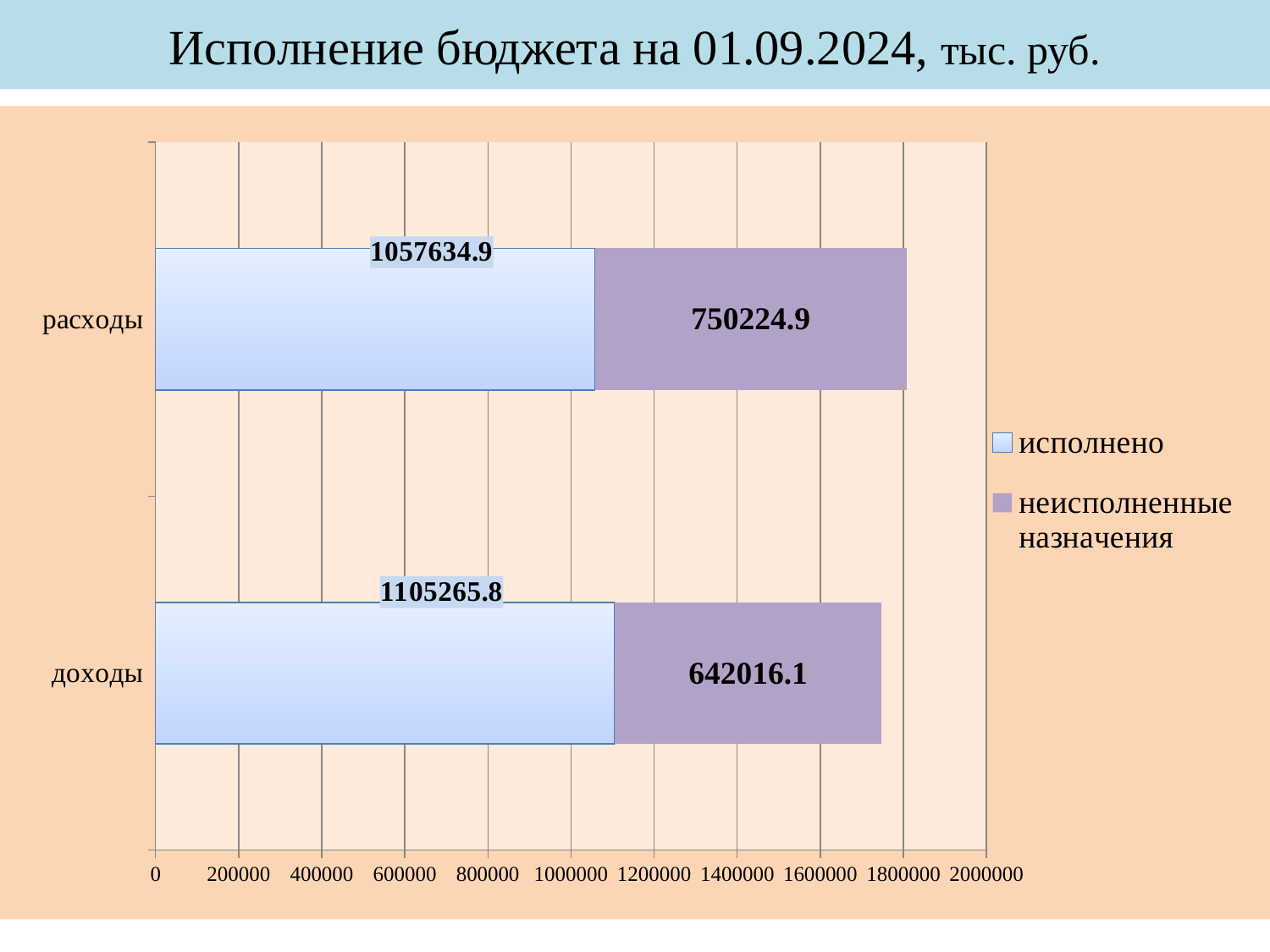
What is the total of the stacked bar for доходы? 1747281.9 What is the total of the stacked bar for расходы? 1807859.8 What is the value of неисполненные назначения for расходы? 750224.9 Which category has the higher исполнено value, расходы or доходы? доходы What is the difference between the неисполненные назначения values for расходы and доходы? 108208.8 What is the value of исполнено for доходы? 1105265.8 What is the difference between the исполнено values for доходы and расходы? 47630.9 Which category has the larger неисполненные назначения value? расходы What is the value of неисполненные назначения for доходы? 642016.1 What is the value of исполнено for расходы? 1057634.9 How many series does the legend list? 2 What kind of chart is shown on the slide? Stacked bar chart